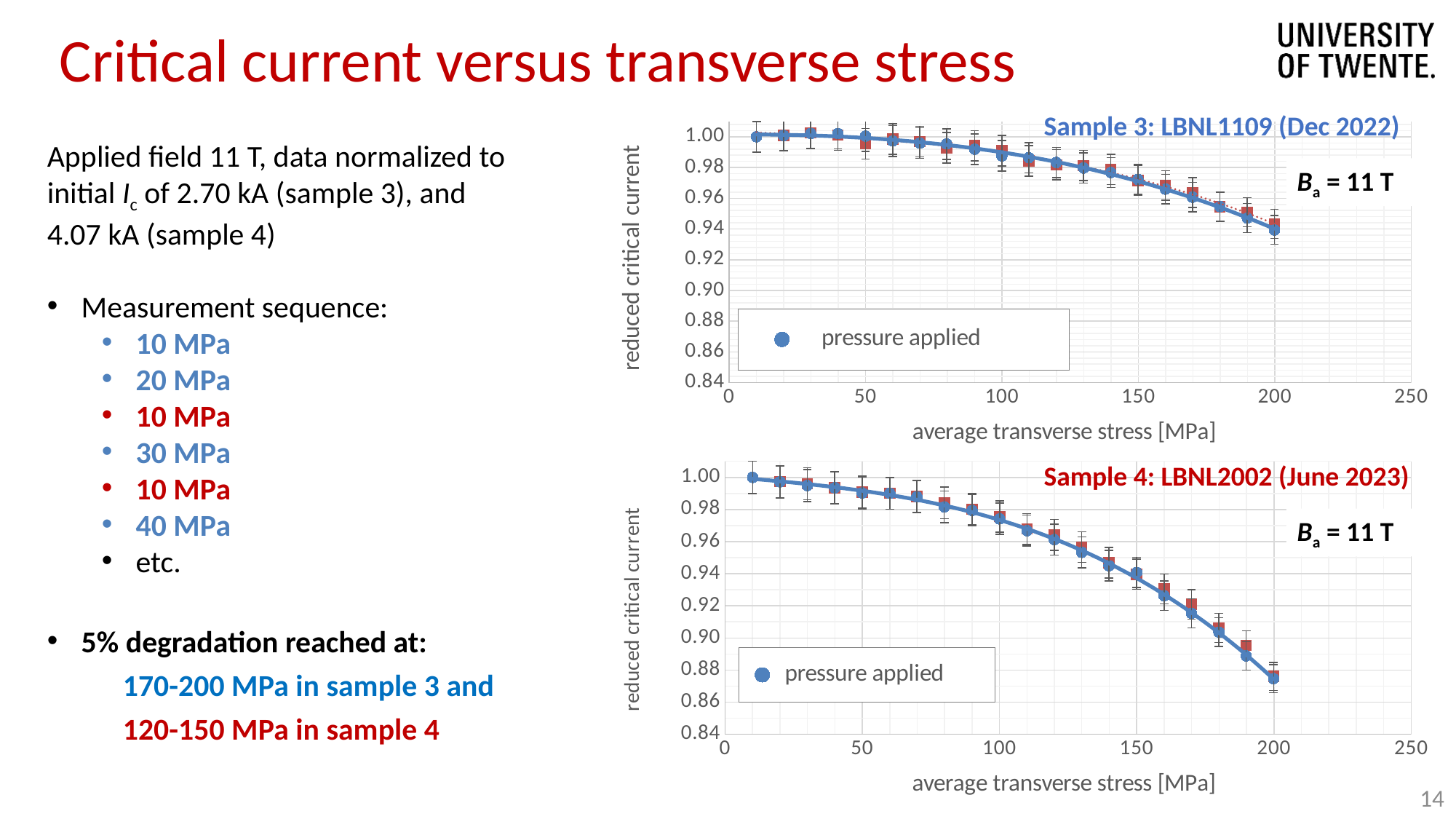
In the bottom chart (Sample 4), is the reduced critical current at 150 MPa greater or less than 0.96? less In the bottom chart (Sample 4), does the reduced critical current rise or fall along the x axis? fall What is the legend entry shown in the bottom chart (Sample 4)? pressure applied In the top chart (Sample 3), is the reduced critical current at 100 MPa greater or less than 0.98? greater What kind of chart is the top chart, Sample 3: LBNL1109 (Dec 2022)? scatter chart with a fitted line What is the x-axis label of the bottom chart (Sample 4)? average transverse stress [MPa] In the bottom chart (Sample 4), is the reduced critical current at 100 MPa greater or less than 0.96? greater How many series does the legend of the top chart (Sample 3) list? 1 In the top chart (Sample 3), does the reduced critical current rise or fall as the average transverse stress increases? fall At 200 MPa, which sample shows the higher reduced critical current, Sample 3 (top chart) or Sample 4 (bottom chart)? Sample 3